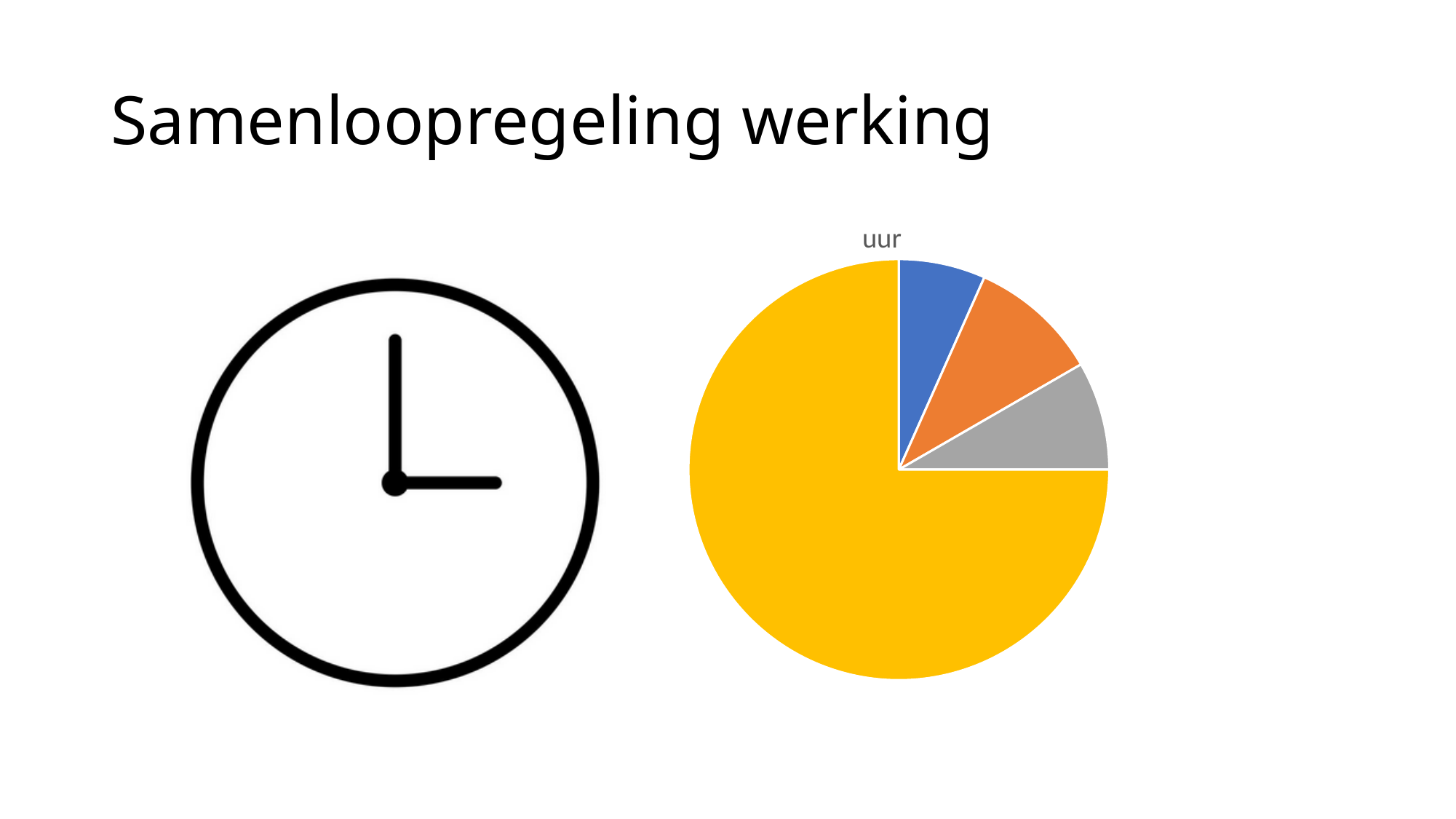
What kind of chart is shown on the slide? pie chart Does the pie chart show a legend? no Does the yellow slice take up more or less than half of the pie chart? more Which slice is larger in the pie chart, the yellow one or the gray one? yellow Which colour slice is the largest in the pie chart? yellow Which slice is larger in the pie chart, the gray one or the blue one? gray How many slices does the pie chart have? 4 What is the title of the pie chart? uur Which slice is larger in the pie chart, the orange one or the blue one? orange Which colour slice is the smallest in the pie chart? blue